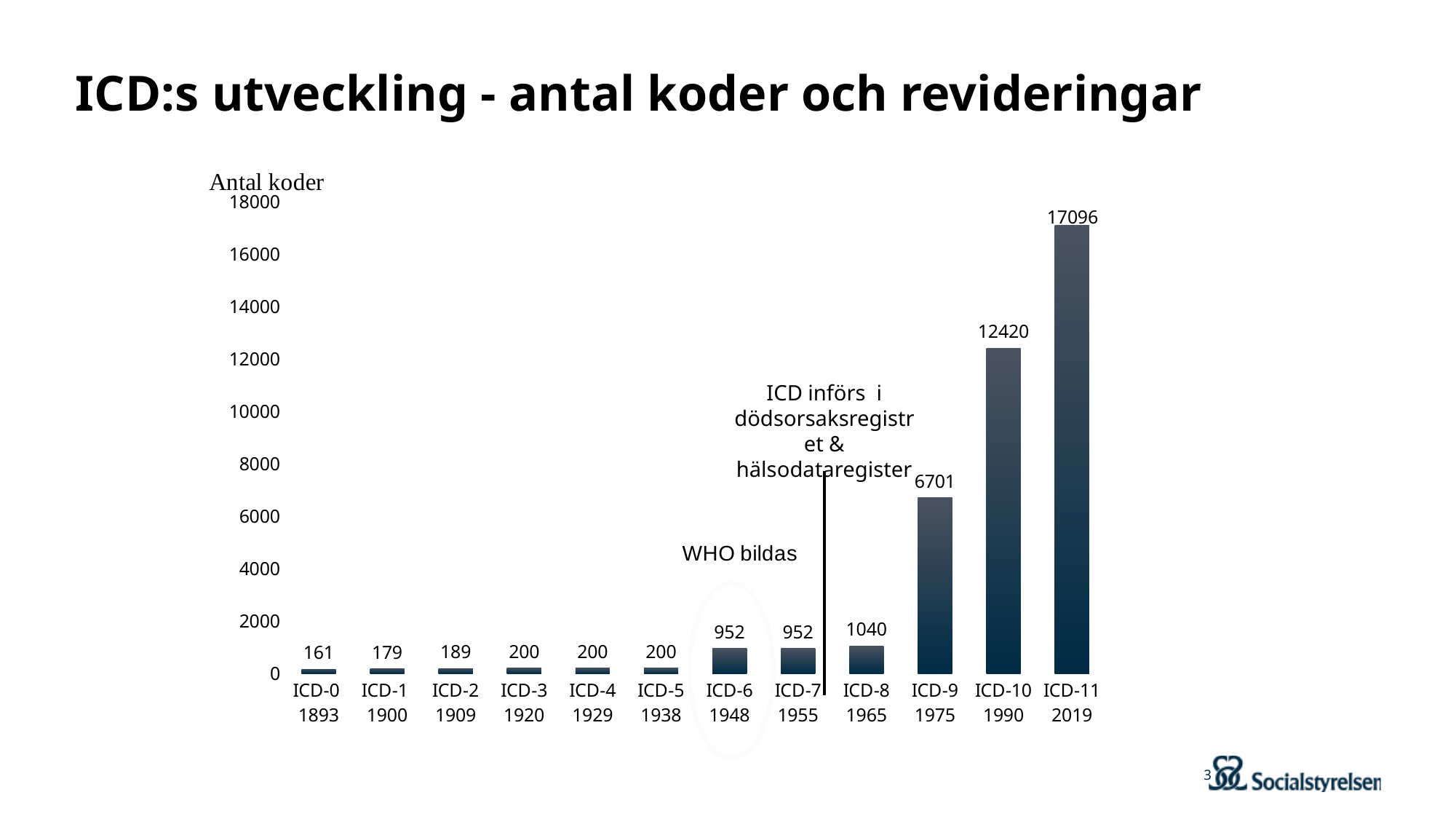
What is the number of codes (Antal koder) for ICD-11 (2019)? 17096 What is the difference in number of codes between ICD-8 and ICD-7? 88 What is the difference in number of codes between ICD-11 and ICD-10? 4676 What kind of chart is shown on the slide? Bar chart Is the value for ICD-10 greater or less than 12000? greater What is the number of codes for ICD-0 (1893)? 161 What is the label of the y axis of the chart? Antal koder How many ICD revisions (bars) are shown in the chart? 12 Which ICD revision has the highest number of codes? ICD-11 Which has more codes, ICD-9 or ICD-10? ICD-10 Which ICD revision has the lowest number of codes? ICD-0 What is the number of codes for ICD-9 (1975)? 6701